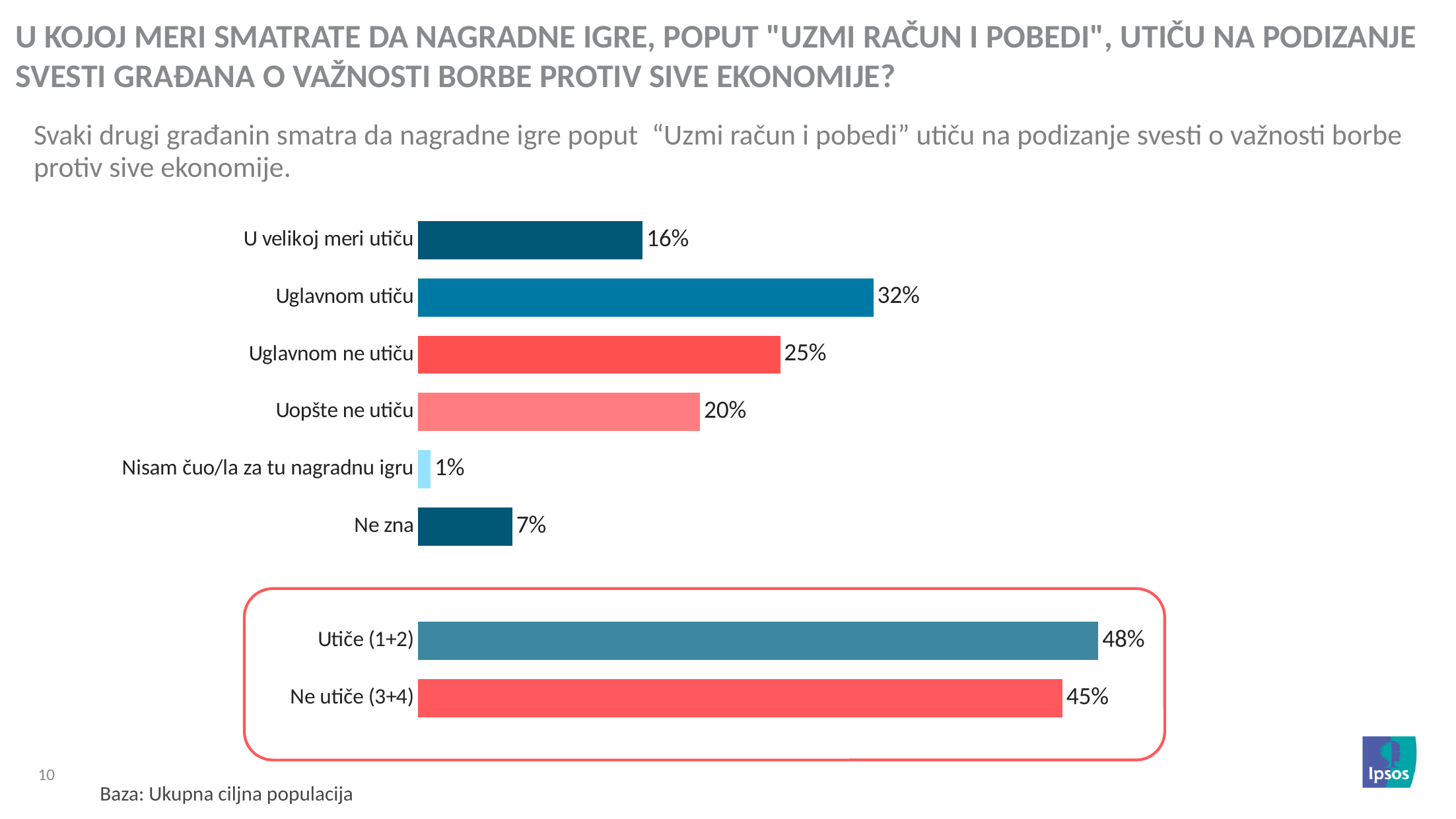
What type of chart is shown on the slide? Bar chart What is the value for "Uglavnom utiču"? 32% Among the six bars above the red-outlined box, which category has the lowest value? Nisam čuo/la za tu nagradnu igru What is the value for "Ne zna"? 7% What is the value for "Uopšte ne utiču"? 20% What is the difference between "Utiče (1+2)" and "Ne utiče (3+4)" in the red-outlined box? 3% What is the value for "Utiče (1+2)" in the red-outlined box? 48% How many categories are shown in the bar chart above the red-outlined box? 6 Which is larger, "Uglavnom ne utiču" or "Uopšte ne utiču"? Uglavnom ne utiču Among the six bars above the red-outlined box, which category has the highest value? Uglavnom utiču What colour is the bar for "Ne utiče (3+4)" in the red-outlined box? Red What is the difference between "Uglavnom ne utiču" and "U velikoj meri utiču"? 9%